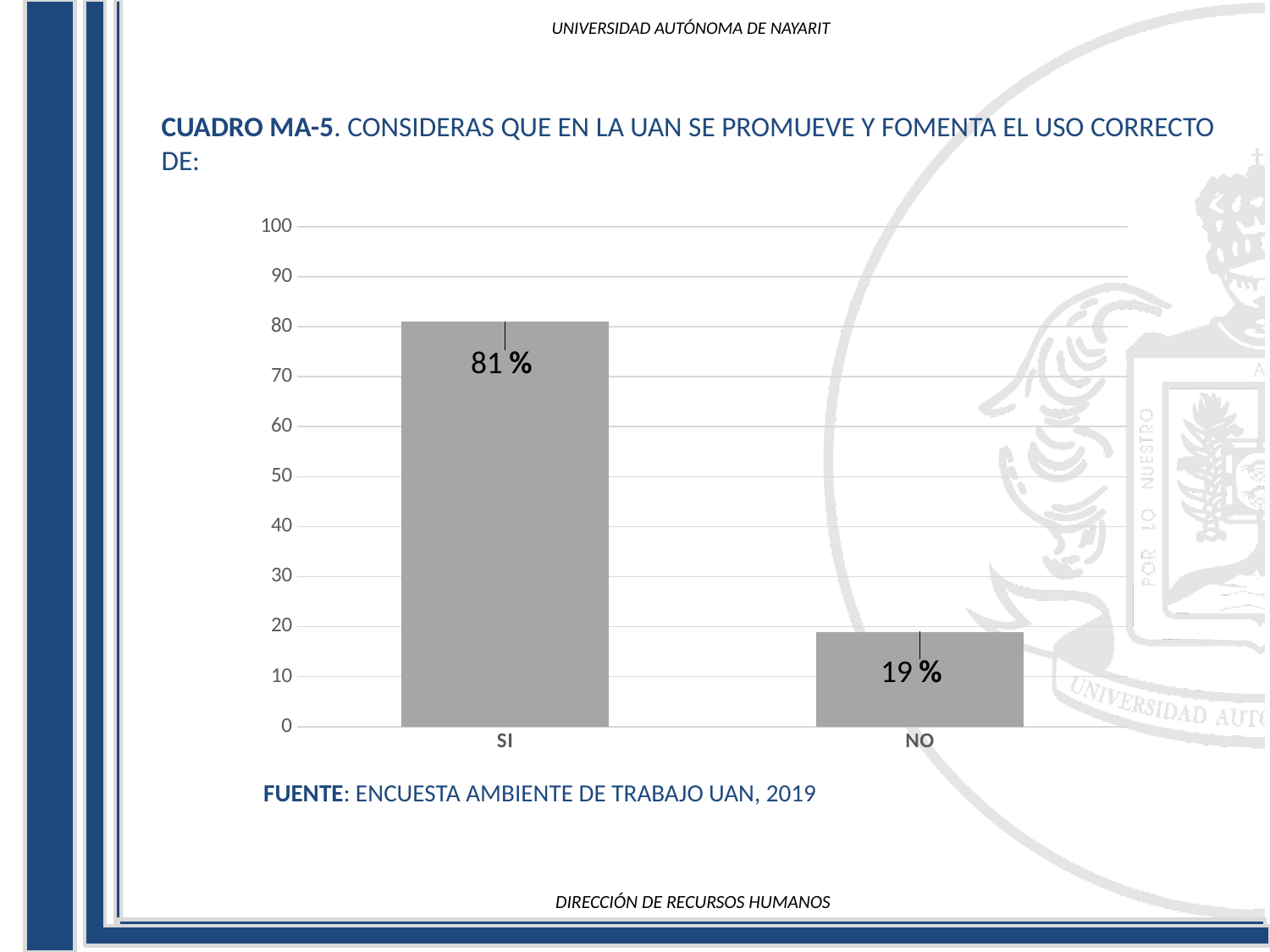
What source is cited below the chart? ENCUESTA AMBIENTE DE TRABAJO UAN, 2019 What kind of chart is shown on the slide? bar chart What is the highest value shown on the vertical axis? 100 Is the value for NO greater or less than 20? less What is the value for NO? 19 % How many categories are shown on the x axis? 2 Is the value for SI greater or less than 50? greater What is the difference between the values for SI and NO? 62 % Which category has the lowest value? NO Which category has the highest value? SI Which is larger, the value for SI or the value for NO? SI What is the value for SI? 81 %